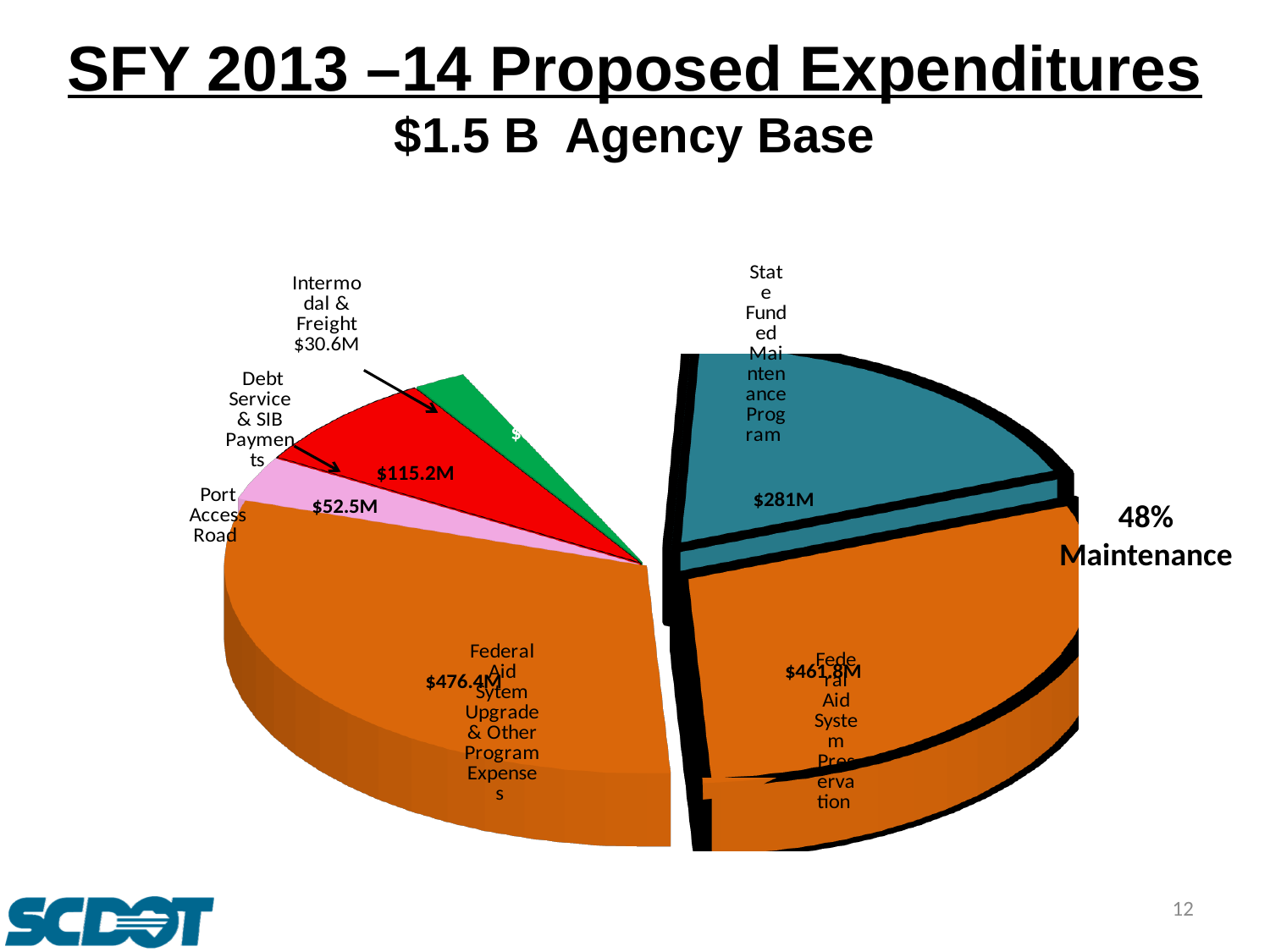
Which is larger, the State Funded Maintenance Program slice or the Debt Service & SIB Payments slice? State Funded Maintenance Program What is the value of the Federal Aid System Upgrade & Other Program Expenses slice? $476.4M What percentage is labelled as Maintenance on the slide? 48% What is the value of the Federal Aid System Preservation slice? $461.8M What is the value of the Debt Service & SIB Payments slice? $115.2M What is the value of the State Funded Maintenance Program slice? $281M Which category has the largest value in the pie chart? Federal Aid System Upgrade & Other Program Expenses What is the value of the Intermodal & Freight slice? $30.6M What is the difference between the Debt Service & SIB Payments value and the Port Access Road value? $62.7M What type of chart is shown on the slide? Pie chart